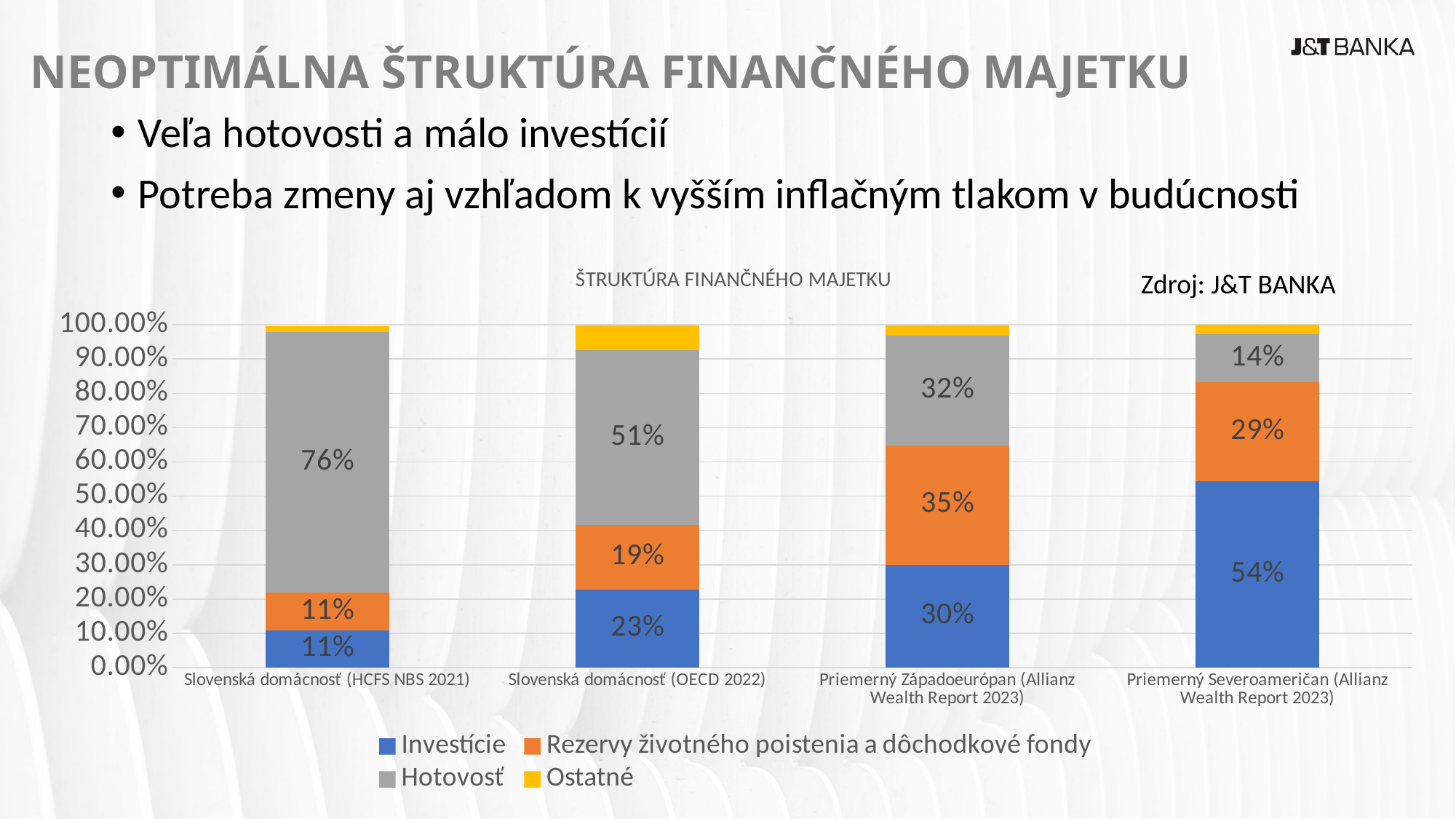
Is the Investície share for Priemerný Severoameričan (Allianz Wealth Report 2023) greater or less than 50%? greater How many series does the chart legend list? 4 What is the Rezervy životného poistenia a dôchodkové fondy share for Priemerný Západoeurópan (Allianz Wealth Report 2023)? 35% How many categories are shown on the x axis of the chart? 4 Which is larger: the Investície share for Priemerný Západoeurópan or for Slovenská domácnosť (OECD 2022)? Priemerný Západoeurópan What is the Investície share for Slovenská domácnosť (OECD 2022)? 23% What kind of chart is shown on the slide? Stacked bar chart What is the difference between the Hotovosť share of Slovenská domácnosť (HCFS NBS 2021) and that of Priemerný Severoameričan (Allianz Wealth Report 2023)? 62 percentage points What is the Investície share for Priemerný Severoameričan (Allianz Wealth Report 2023)? 54% Which category has the highest Hotovosť share? Slovenská domácnosť (HCFS NBS 2021) Which category has the lowest Investície share? Slovenská domácnosť (HCFS NBS 2021) What is the Hotovosť share for Slovenská domácnosť (HCFS NBS 2021)? 76%